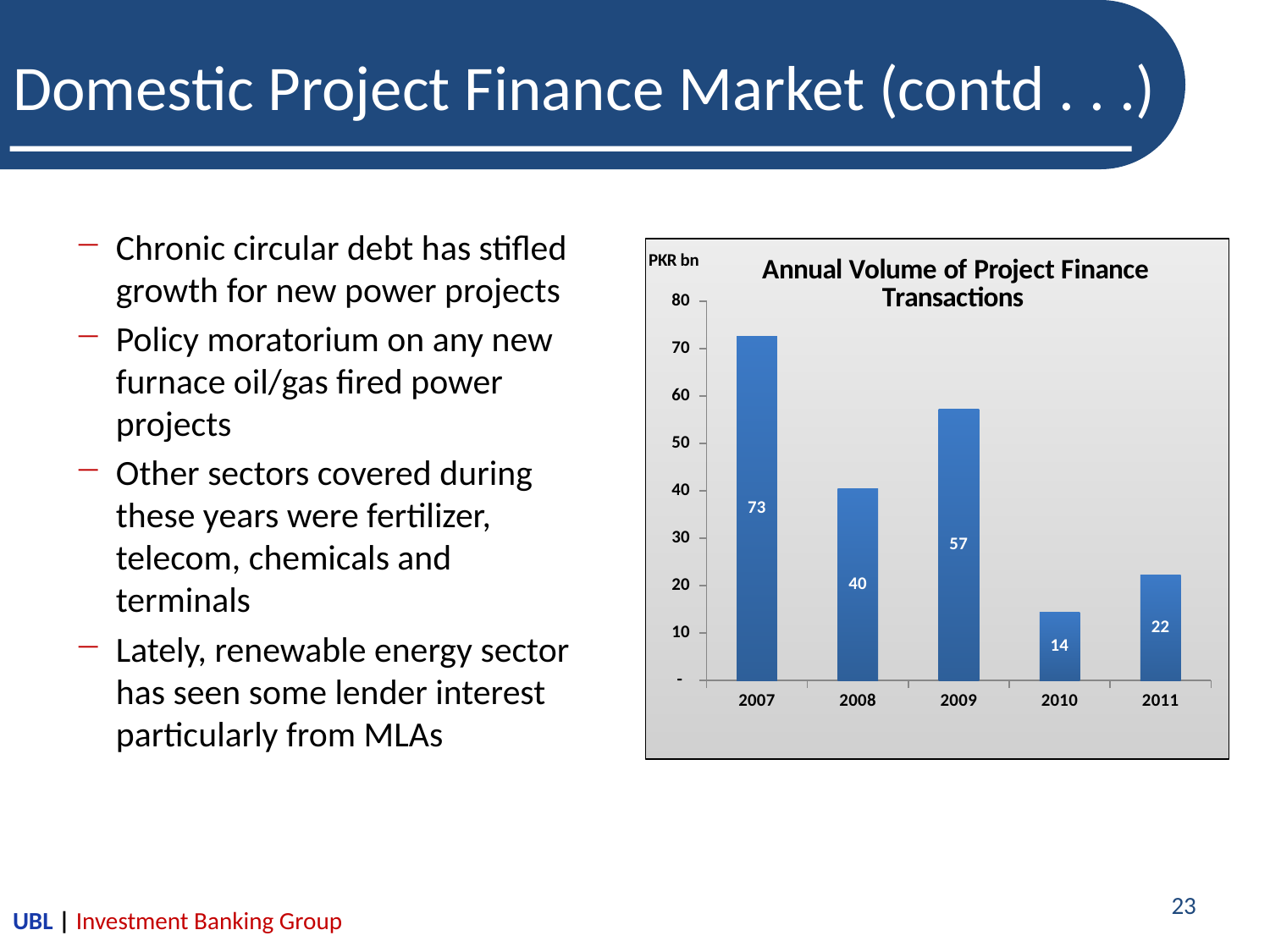
How many years are shown on the x axis of the chart? 5 What is the value for 2010 in the Annual Volume of Project Finance Transactions chart? 14 Which year has the highest annual volume of project finance transactions? 2007 Which is larger, the value for 2008 or the value for 2009? 2009 What is the difference between the values for 2008 and 2010? 26 Which year has the lowest annual volume of project finance transactions? 2010 What kind of chart is shown on the slide? bar chart What is the value for 2011 in the Annual Volume of Project Finance Transactions chart? 22 What is the difference between the values for 2007 and 2009? 16 What unit is indicated in the top-left corner of the chart? PKR bn Is the value for 2011 greater or less than 30? less What is the value for 2007 in the Annual Volume of Project Finance Transactions chart? 73